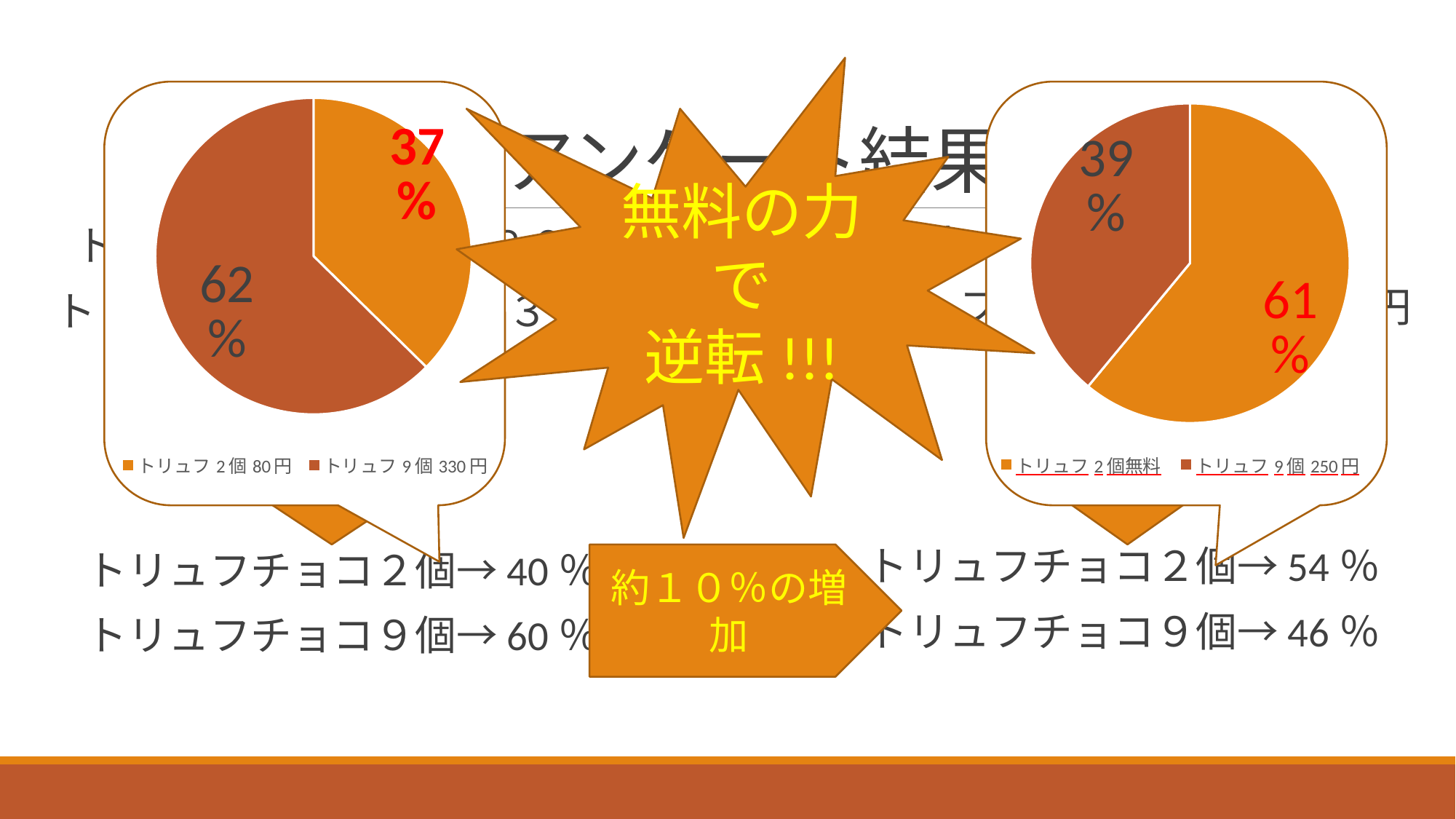
On the left pie chart, what is the difference in percentage points between トリュフ 9個 330円 and トリュフ 2個 80円? 25 On the left pie chart, what percentage is shown for トリュフ 9個 330円? 62% On the right pie chart, which category has the smallest slice? トリュフ 9個 250円 On the right pie chart, what is the difference in percentage points between トリュフ 2個無料 and トリュフ 9個 250円? 22 On the right pie chart, what percentage is shown for トリュフ 9個 250円? 39% How many entries does the legend of the right pie chart list? 2 How many slices does the left pie chart have? 2 On the left pie chart, what percentage is shown for トリュフ 2個 80円? 37% On the left pie chart, which category has the largest slice? トリュフ 9個 330円 On the right pie chart, which is larger: トリュフ 2個無料 or トリュフ 9個 250円? トリュフ 2個無料 On the right pie chart, what percentage is shown for トリュフ 2個無料? 61% What type of chart is shown on the right side of the slide? Pie chart